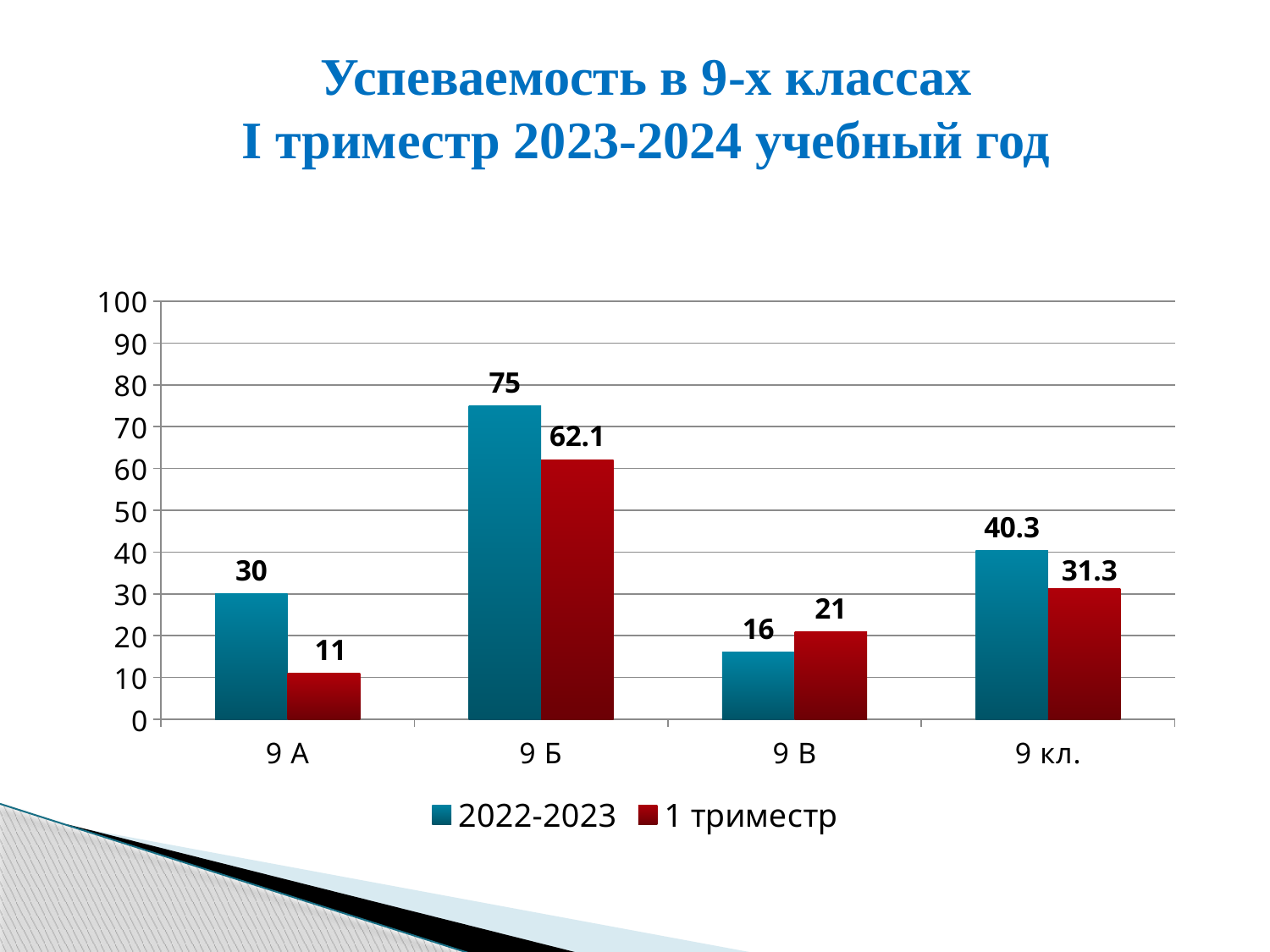
What is the value for 9 Б in the 2022-2023 series? 75 How many categories are shown on the x axis? 4 Is the 2022-2023 value for 9 кл. greater or less than 50? less What is the value for 9 кл. in the 1 триместр series? 31.3 Which category has the highest value in the 1 триместр series? 9 Б What kind of chart is shown on the slide? bar chart What is the difference between the 2022-2023 and 1 триместр values for 9 А? 19 How many series does the legend list? 2 Which category has the lowest value in the 2022-2023 series? 9 В For 9 В, which series has the larger value, 2022-2023 or 1 триместр? 1 триместр What is the value for 9 А in the 1 триместр series? 11 What is the difference between the 2022-2023 and 1 триместр values for 9 Б? 12.9